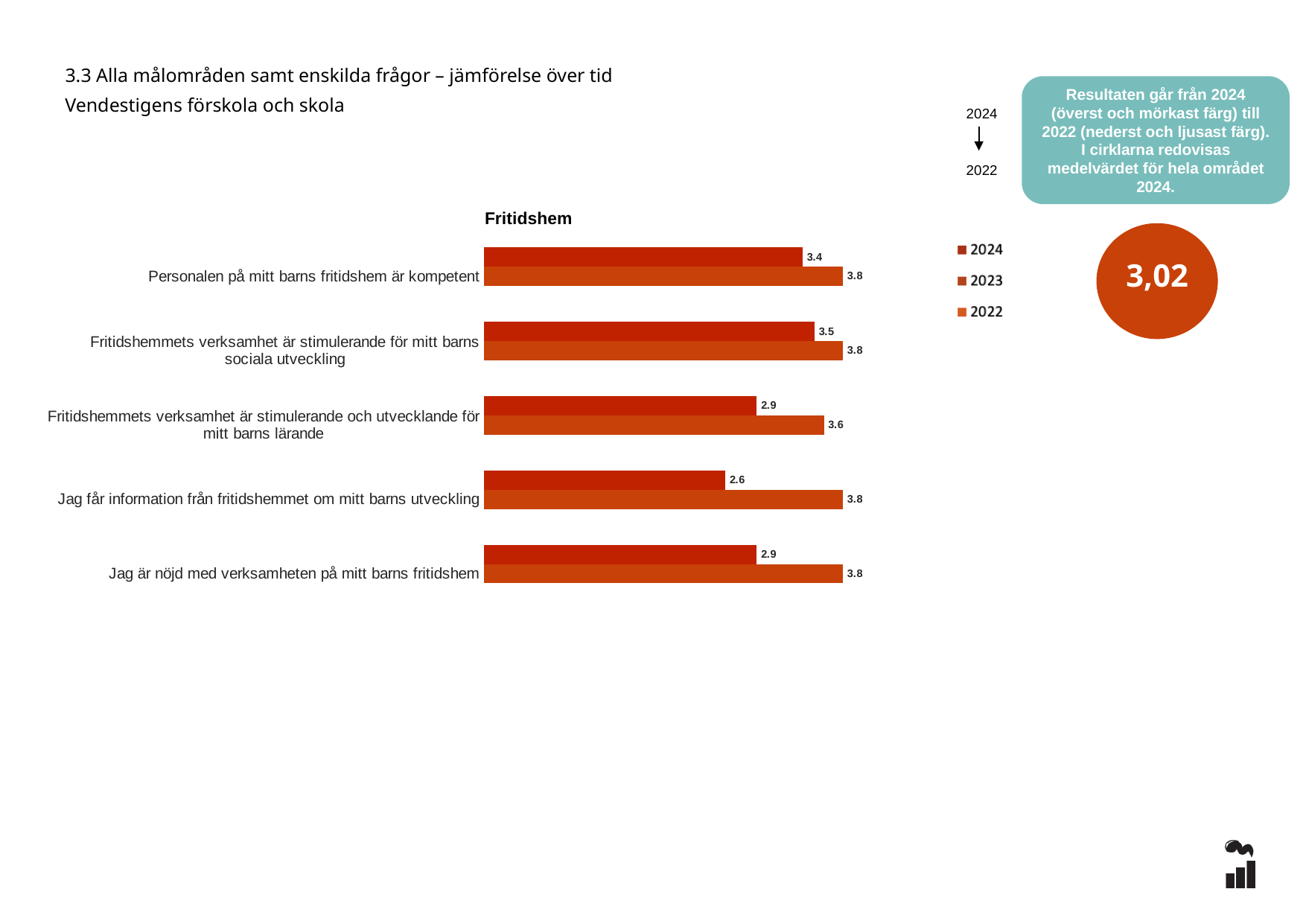
In the Fritidshem chart, which statement has the lowest 2024 value? Jag får information från fritidshemmet om mitt barns utveckling In the Fritidshem chart, which statement has the highest 2024 value? Fritidshemmets verksamhet är stimulerande för mitt barns sociala utveckling What type of chart is the Fritidshem chart? Bar chart In the Fritidshem chart, what value is shown on the lighter, lower bar for "Fritidshemmets verksamhet är stimulerande och utvecklande för mitt barns lärande"? 3.6 What mean value is shown in the orange circle on the slide? 3,02 How many series does the legend of the Fritidshem chart list? 3 In the Fritidshem chart, for "Jag får information från fritidshemmet om mitt barns utveckling", what is the difference between the lighter bar (3.8) and the 2024 bar (2.6)? 1.2 In the Fritidshem chart, what is the 2024 value for "Jag får information från fritidshemmet om mitt barns utveckling"? 2.6 In the Fritidshem chart, what is the 2024 value (top, darkest bar) for "Personalen på mitt barns fritidshem är kompetent"? 3.4 How many statements (categories) are shown in the Fritidshem chart? 5 In the Fritidshem chart, for "Personalen på mitt barns fritidshem är kompetent", how much higher is the lighter bar than the 2024 bar? 0.4 In the Fritidshem chart, which has the higher 2024 value: "Personalen på mitt barns fritidshem är kompetent" or "Jag är nöjd med verksamheten på mitt barns fritidshem"? Personalen på mitt barns fritidshem är kompetent